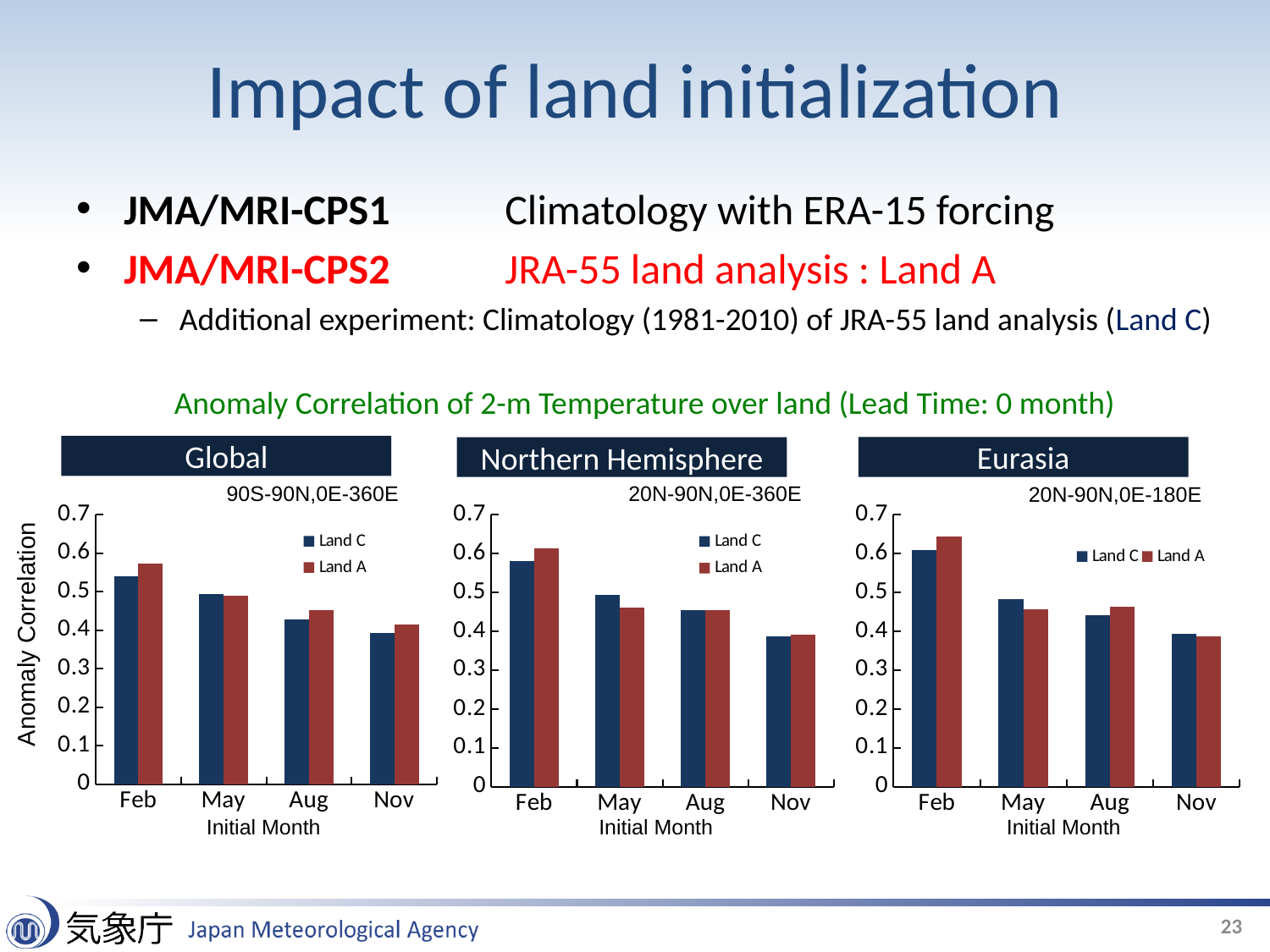
What kind of chart is the Global chart? bar chart In the Eurasia chart, is the Land A value for Feb greater or less than 0.6? greater In the Northern Hemisphere chart, is the Land C value for Feb greater or less than 0.5? greater How many initial months are shown on the x axis of the Northern Hemisphere chart? 4 In the Eurasia chart, do the Land C values rise or fall from Feb to Nov? fall In the Northern Hemisphere chart, which initial month has the lowest Land C anomaly correlation? Nov What is the region label shown under the Eurasia chart title? 20N-90N,0E-180E In the Northern Hemisphere chart, which is larger for May, Land C or Land A? Land C In the Eurasia chart, which is larger for Feb, Land C or Land A? Land A In the Global chart, which initial month has the highest Land A anomaly correlation? Feb How many series does the legend of the Eurasia chart list? 2